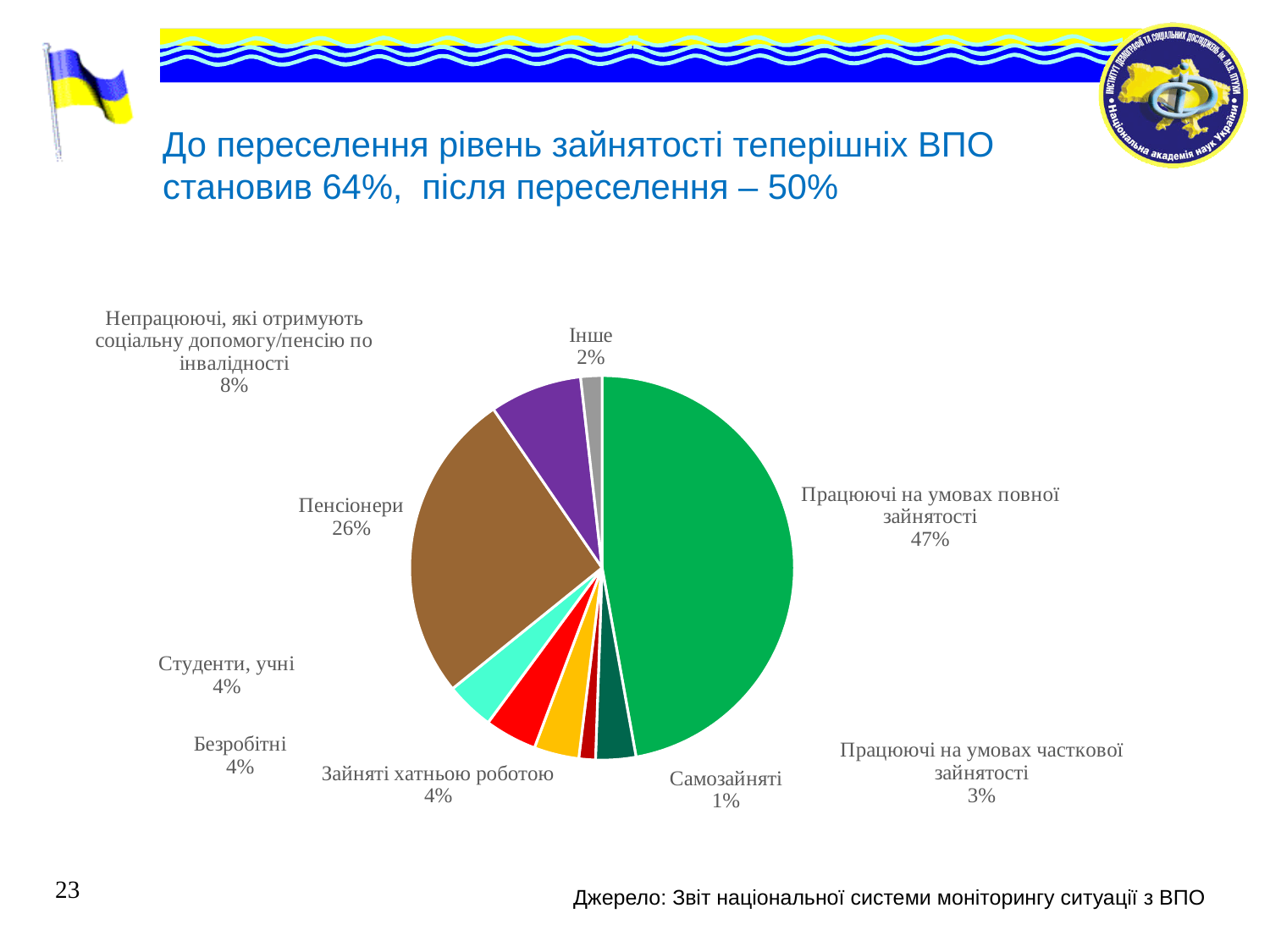
Which is larger: the slice for Пенсіонери or the slice for Непрацюючі, які отримують соціальну допомогу/пенсію по інвалідності? Пенсіонери Which category has the largest slice of the pie? Працюючі на умовах повної зайнятості What is the value shown for Непрацюючі, які отримують соціальну допомогу/пенсію по інвалідності? 8% How many categories are shown in the pie chart? 9 What kind of chart is shown on the slide? Pie chart What is the value shown for Пенсіонери? 26% What is the value shown for Інше? 2% Which category has the smallest slice of the pie? Самозайняті What is the value shown for Працюючі на умовах часткової зайнятості? 3% What share of the pie does the slice for Працюючі на умовах повної зайнятості represent? 47% What is the value shown for Самозайняті? 1% What is the difference in percentage points between Працюючі на умовах повної зайнятості and Пенсіонери? 21 percentage points